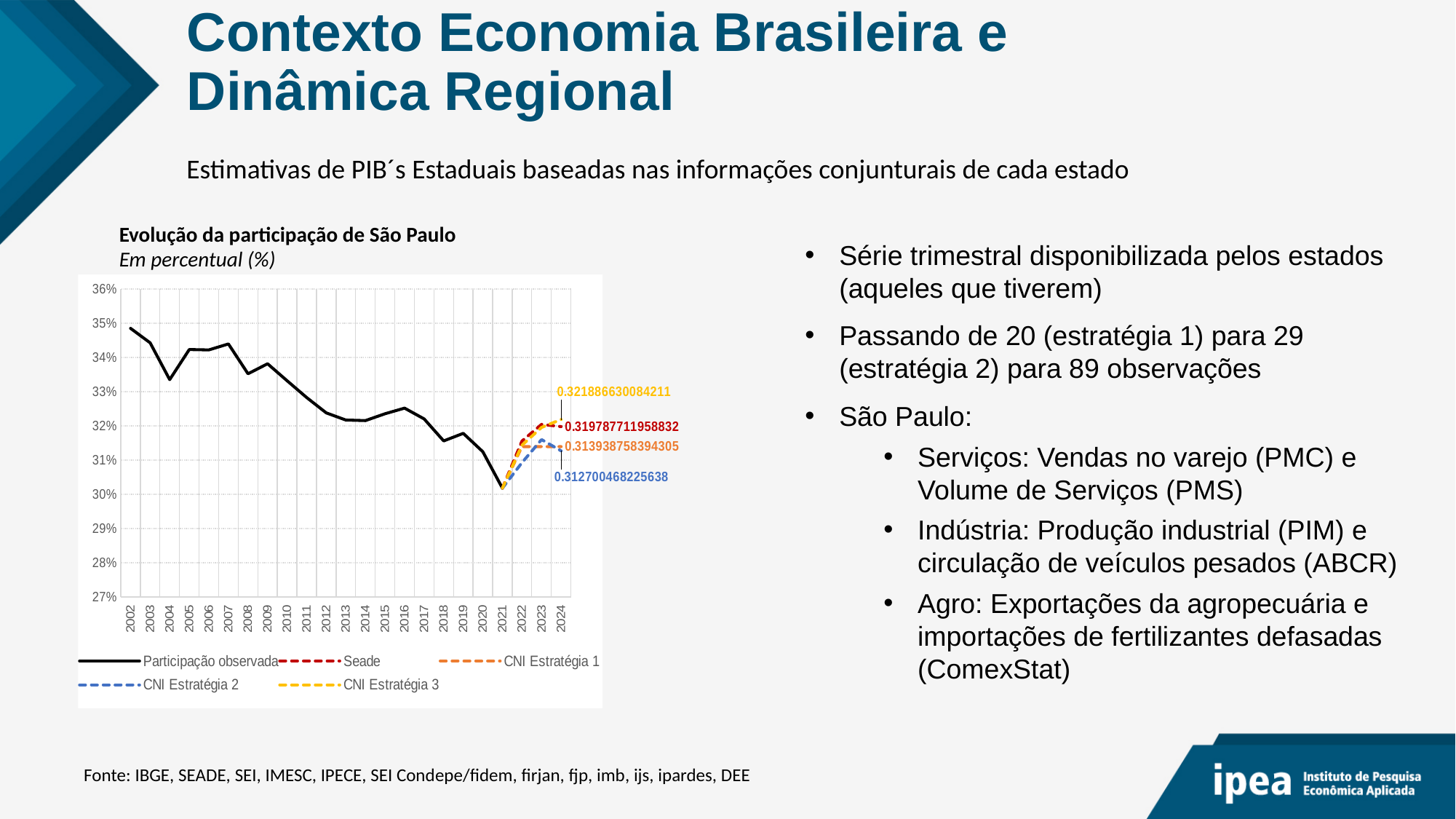
Which series has the highest labelled value in 2024? CNI Estratégia 3 What kind of chart is shown on the slide? Line chart What is the title of the chart? Evolução da participação de São Paulo How many series does the legend of the chart list? 5 Is the Participação observada value for 2002 greater or less than 34%? greater Does the Participação observada series generally rise or fall from 2002 to 2021? Fall What is the 2024 value labelled for the CNI Estratégia 2 series? 0.312700468225638 Which series has the lowest labelled value in 2024? CNI Estratégia 2 What is the 2024 value labelled for the CNI Estratégia 3 series? 0.321886630084211 What is the 2024 value labelled for the Seade series? 0.319787711958832 How many years are shown on the x axis of the chart? 23 Which is larger in 2024, the Seade value or the CNI Estratégia 1 value? Seade